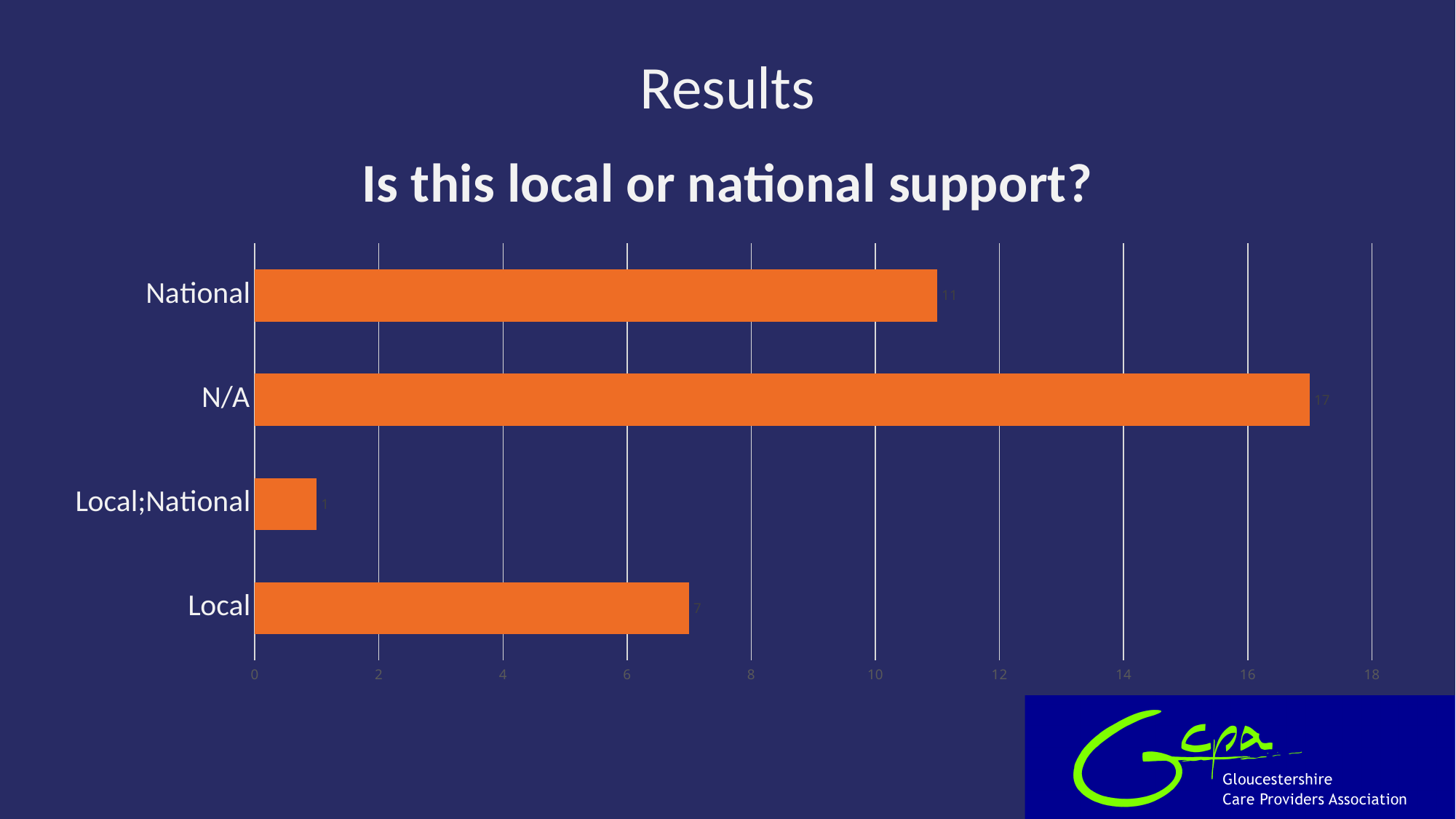
Which category has the highest value? N/A Which is larger, the value for Local or the value for National? National What is the value for Local? 7 Is the value for N/A greater or less than 16? greater What is the difference between the values for National and Local? 4 How many categories are shown in the chart? 4 Which category has the lowest value? Local;National What is the value for Local;National? 1 What is the difference between the values for N/A and National? 6 What kind of chart is shown on the slide? bar chart What is the value for National? 11 What is the value for N/A? 17